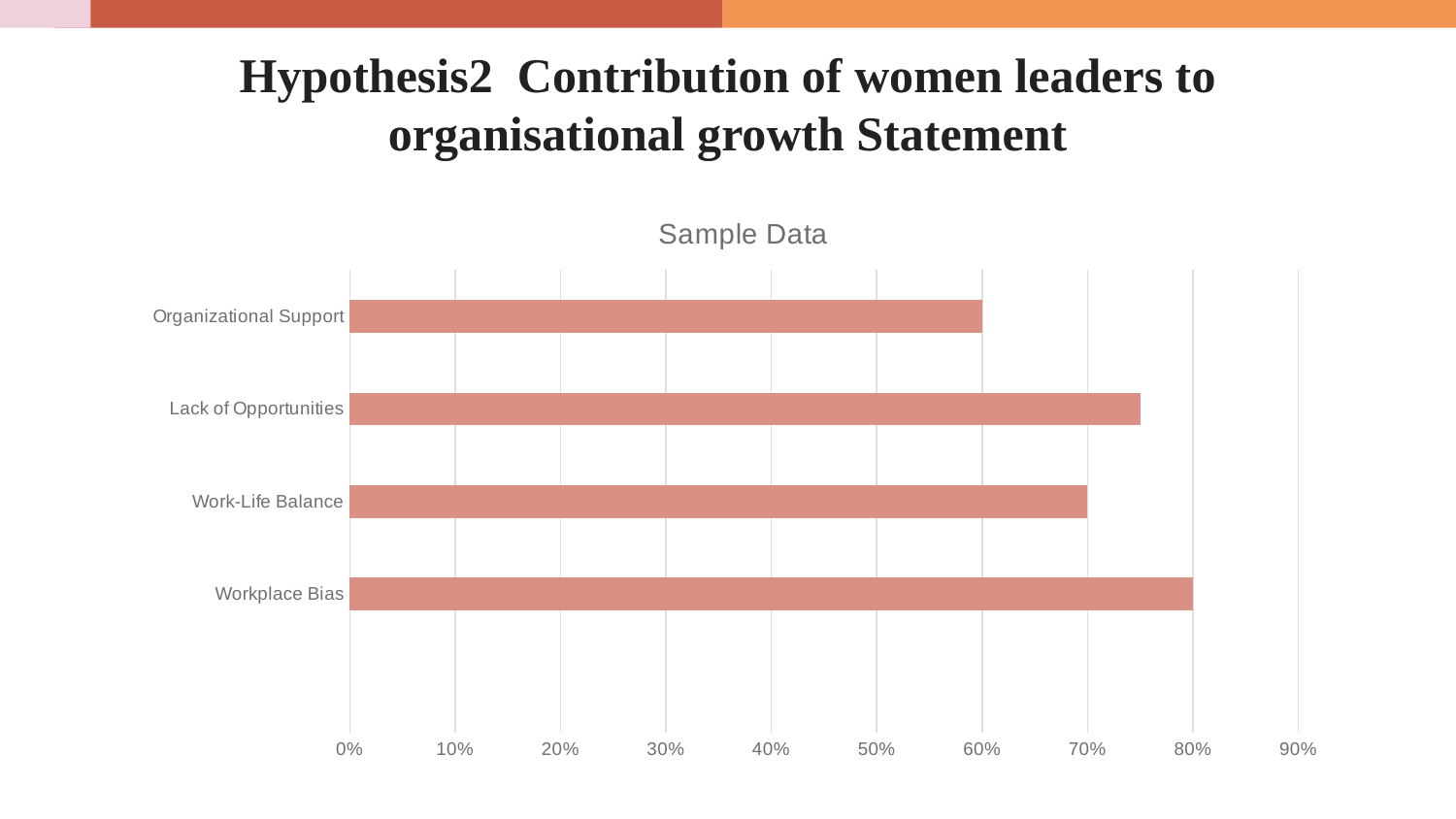
What is the difference between the value for Workplace Bias and the value for Organizational Support? 20% What is the title of the chart? Sample Data Which category has the highest value? Workplace Bias What is the value for Work-Life Balance? 70% How many categories are plotted in the chart? 4 Which is larger, the value for Work-Life Balance or the value for Organizational Support? Work-Life Balance What is the value for Organizational Support? 60% Is the value for Lack of Opportunities greater or less than 80%? less Which category has the lowest value? Organizational Support Is the value for Lack of Opportunities greater or less than 70%? greater What type of chart is shown on the slide? Bar chart What is the value for Workplace Bias? 80%